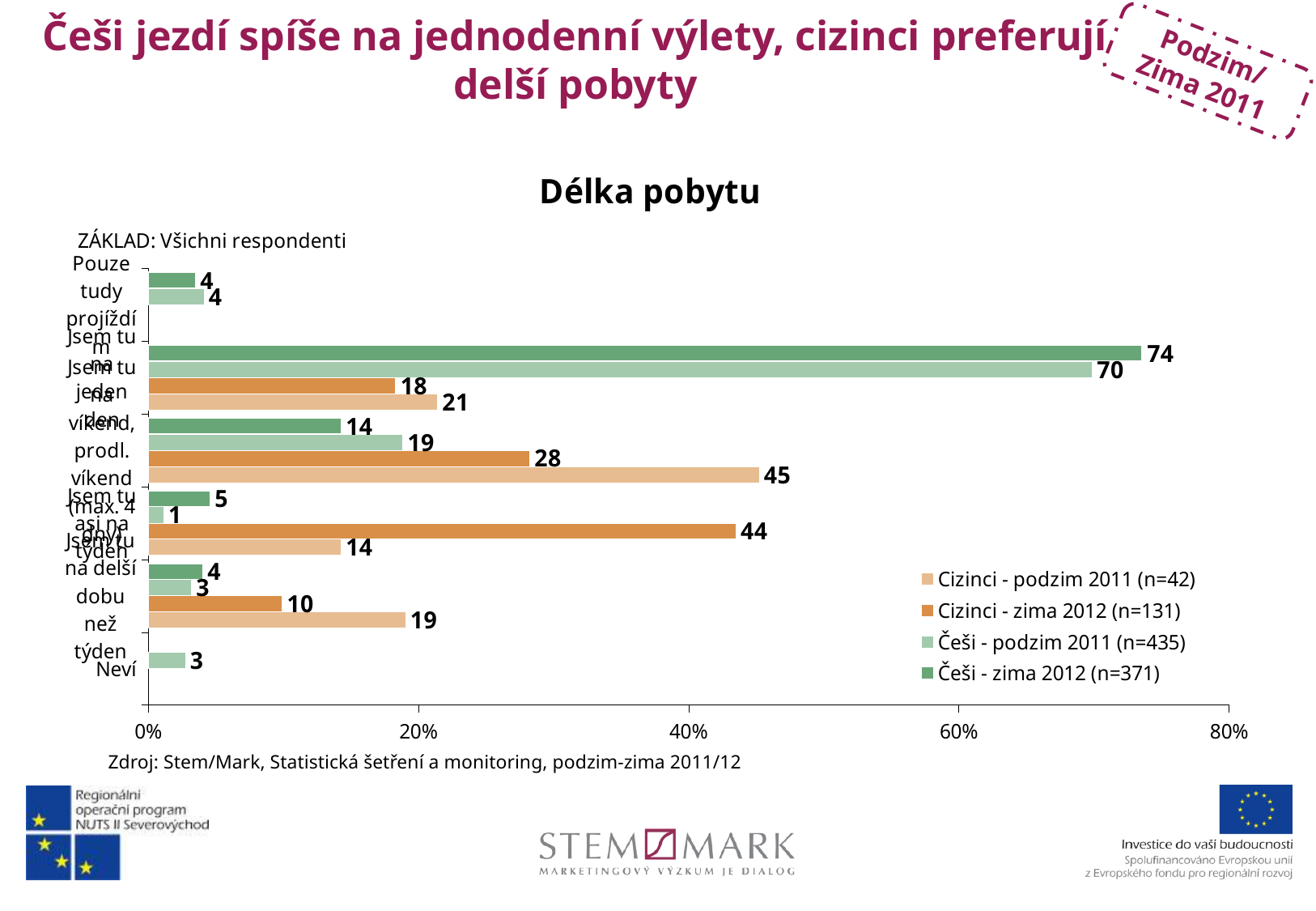
What is the difference between the highest values of "Češi - zima 2012 (n=371)" (74) and "Češi - podzim 2011 (n=435)" (70)? 4 What is the lowest value shown for the series "Češi - podzim 2011 (n=435)"? 1 How many series does the legend of the "Délka pobytu" chart list? 4 Which is larger: the highest value for "Cizinci - podzim 2011 (n=42)" or the highest value for "Cizinci - zima 2012 (n=131)"? Cizinci - podzim 2011 (n=42) Is the longest bar for "Češi - zima 2012 (n=371)" greater or less than 60%? greater Is the longest bar for "Cizinci - zima 2012 (n=131)" greater or less than 60%? less What is the highest value shown for the series "Cizinci - zima 2012 (n=131)"? 44 What kind of chart is shown under the title "Délka pobytu"? bar chart What is the title of the chart on the slide? Délka pobytu What is the highest value shown for the series "Cizinci - podzim 2011 (n=42)"? 45 What is the highest value shown for the series "Češi - zima 2012 (n=371)"? 74 What is the value for "Češi - podzim 2011 (n=435)" in the "Neví" category? 3